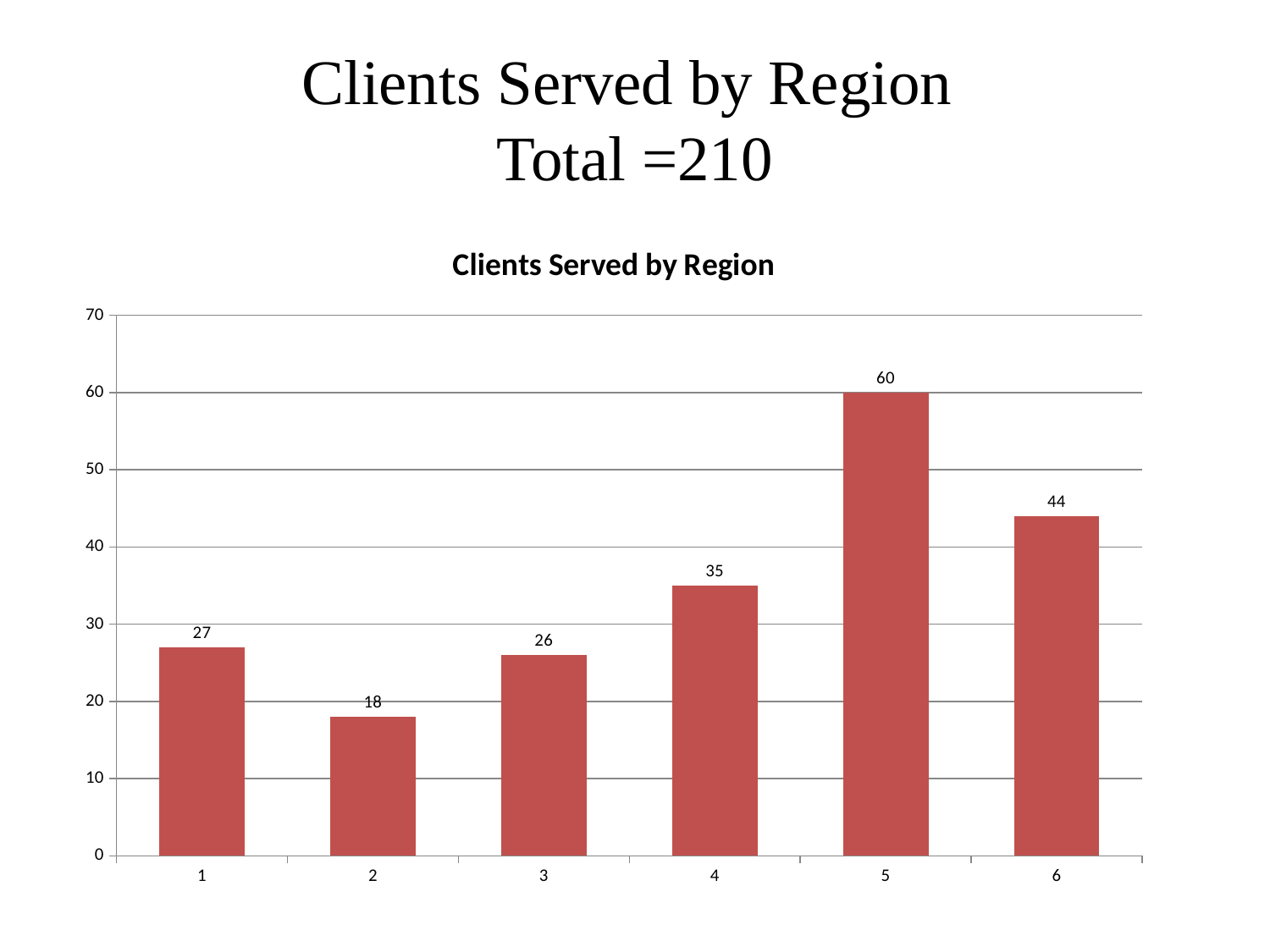
Is the value for region 6 greater or less than 40? greater What is the difference between the values for region 5 and region 6? 16 What kind of chart is shown? Bar chart What is the value for region 5? 60 What is the value for region 1? 27 Which is larger, the value for region 1 or the value for region 4? Region 4 What is the value for region 3? 26 How many regions are shown on the x axis? 6 What is the title of the chart? Clients Served by Region Which region has the lowest number of clients served? 2 What is the difference between the values for region 4 and region 2? 17 Which region has the highest number of clients served? 5